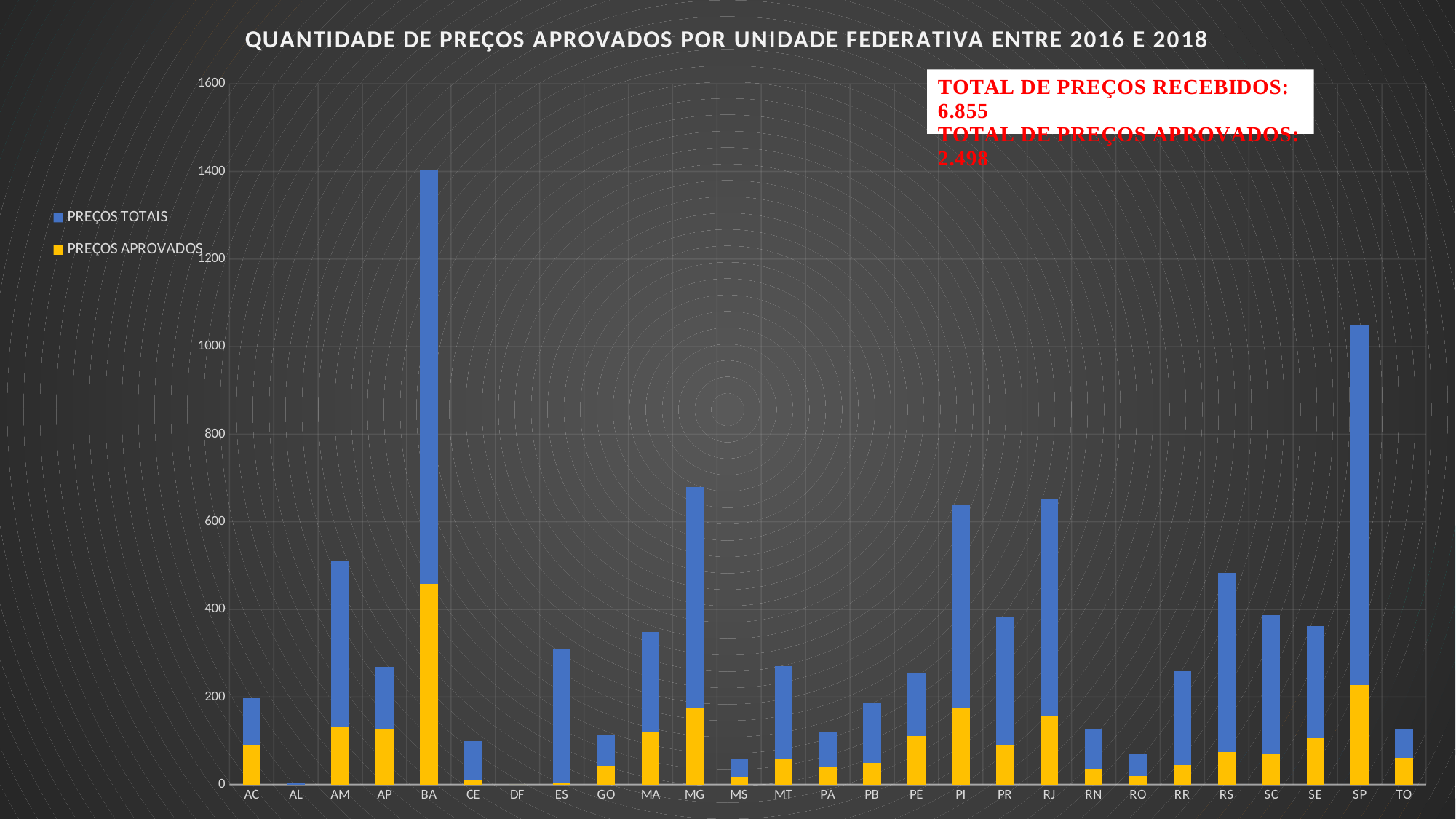
How many series does the legend list? 2 Is the total bar for MG greater or less than 600? greater Which state has the larger PREÇOS APROVADOS segment, BA or SP? BA Is the total bar for MS greater or less than 100? less What type of chart is shown on the slide? Bar chart Which state has the highest total bar? BA Which has the larger total bar, AM or AP? AM Is the total bar for SP greater or less than 1000? greater How many states (unidades federativas) are shown on the x axis? 27 According to the text box on the slide, what is the total of prices approved (TOTAL DE PREÇOS APROVADOS)? 2.498